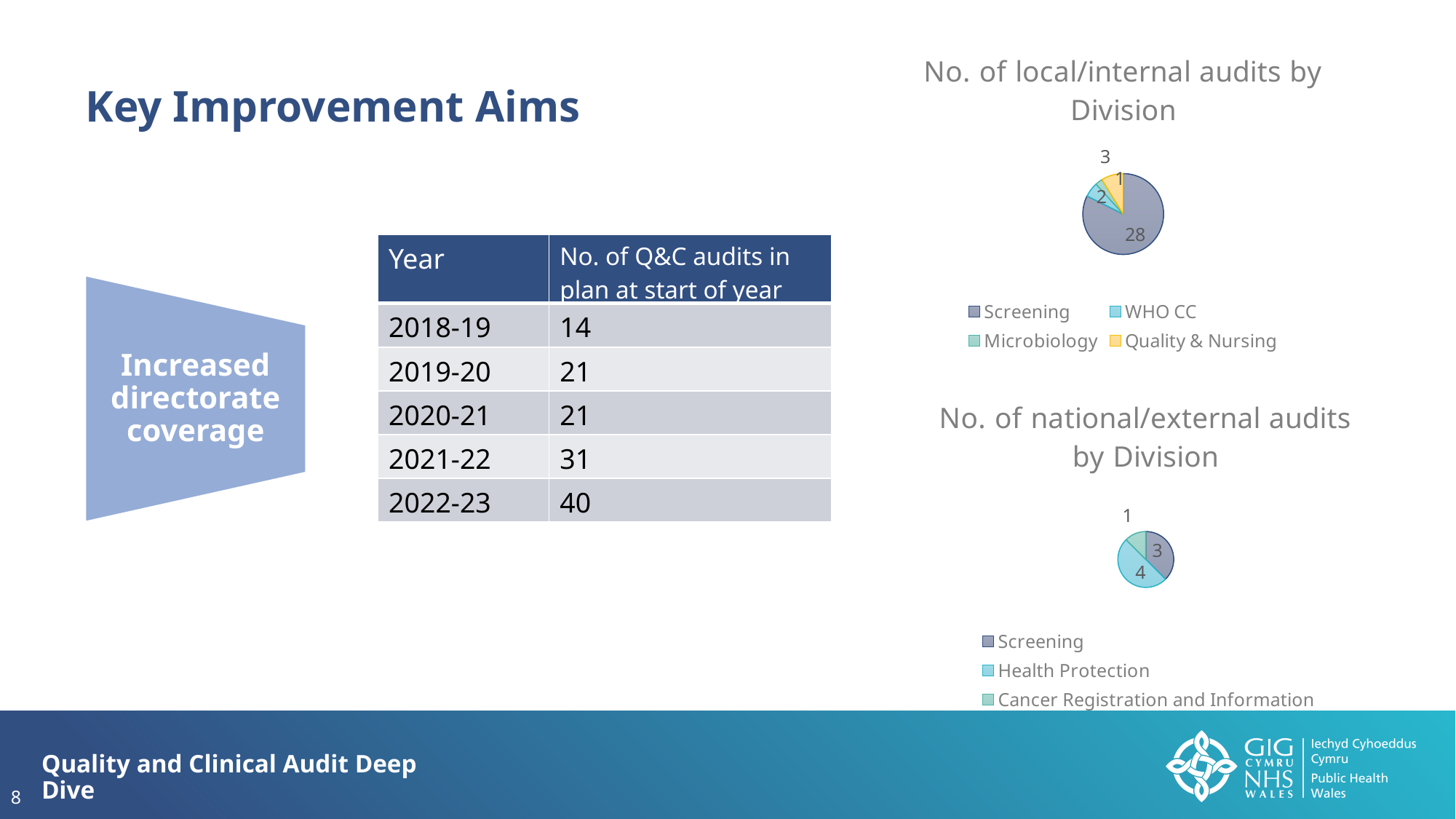
In the 'No. of national/external audits by Division' chart, what is the value for Health Protection? 4 How many divisions does the legend of the 'No. of local/internal audits by Division' chart list? 4 In the 'No. of national/external audits by Division' chart, which division has the largest slice? Health Protection What kind of chart is 'No. of local/internal audits by Division'? Pie chart In the 'No. of national/external audits by Division' chart, what is the value for Screening? 3 In the 'No. of local/internal audits by Division' chart, what is the total of all slices? 34 In the 'No. of national/external audits by Division' chart, which division has the smallest slice? Cancer Registration and Information How many slices does the 'No. of national/external audits by Division' pie chart have? 3 In the 'No. of national/external audits by Division' chart, what is the difference between Health Protection and Screening? 1 In the 'No. of local/internal audits by Division' chart, which division has the largest slice? Screening In the 'No. of national/external audits by Division' chart, what is the total of all slices? 8 In the 'No. of local/internal audits by Division' chart, what is the value for Screening? 28